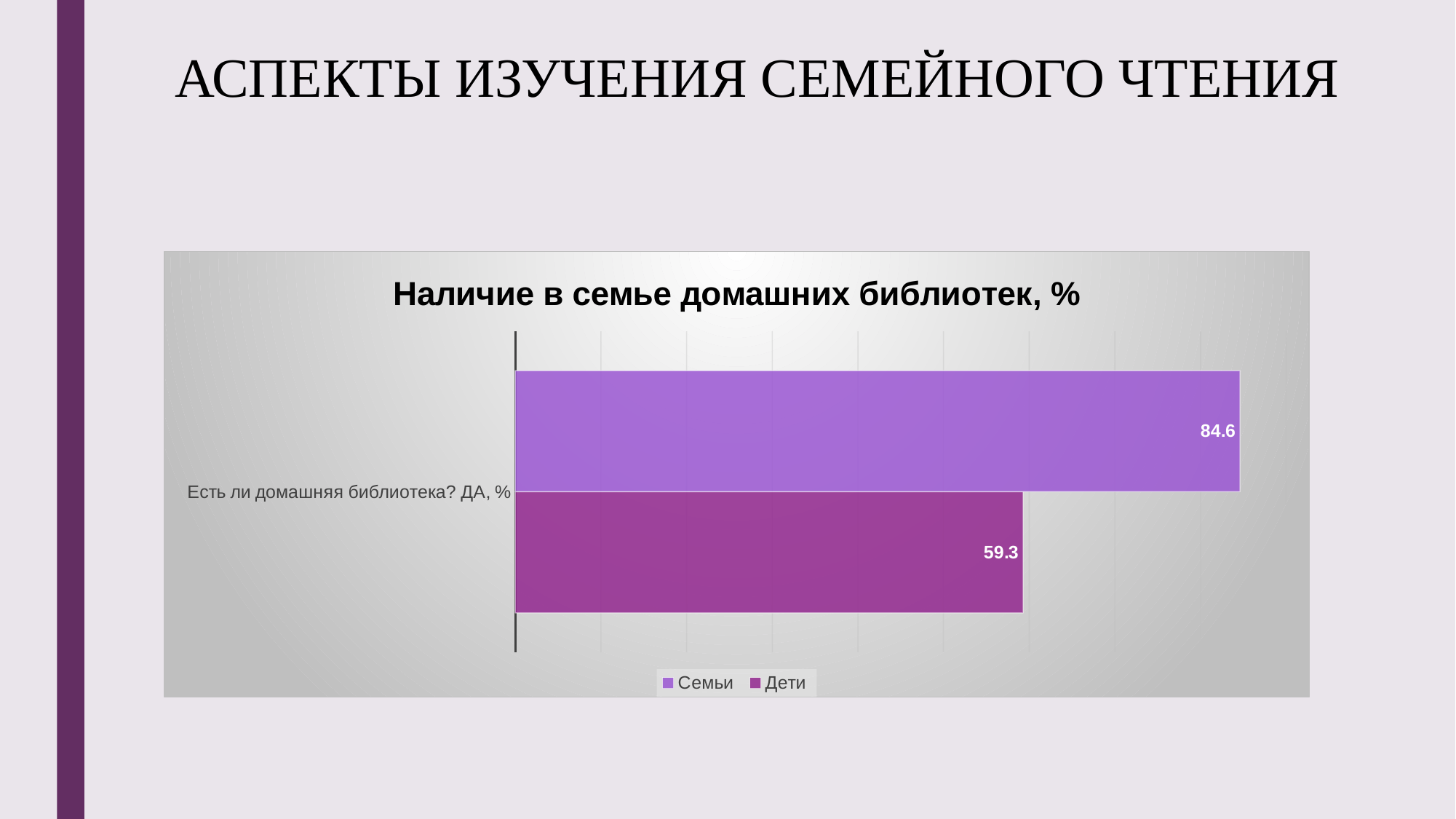
How many series does the legend list? 2 Which series has the lowest value in the chart? Дети What is the value for Дети in the chart? 59.3 Which series has the highest value in the chart? Семьи What is the title of the chart? Наличие в семье домашних библиотек, % What is the value for Семьи in the chart? 84.6 How many categories are shown on the category axis? 1 What kind of chart is shown on the slide? Bar chart What is the difference between the values for Семьи and Дети? 25.3 Which series has the higher value, Семьи or Дети? Семьи What is the label of the category on the axis? Есть ли домашняя библиотека? ДА, %